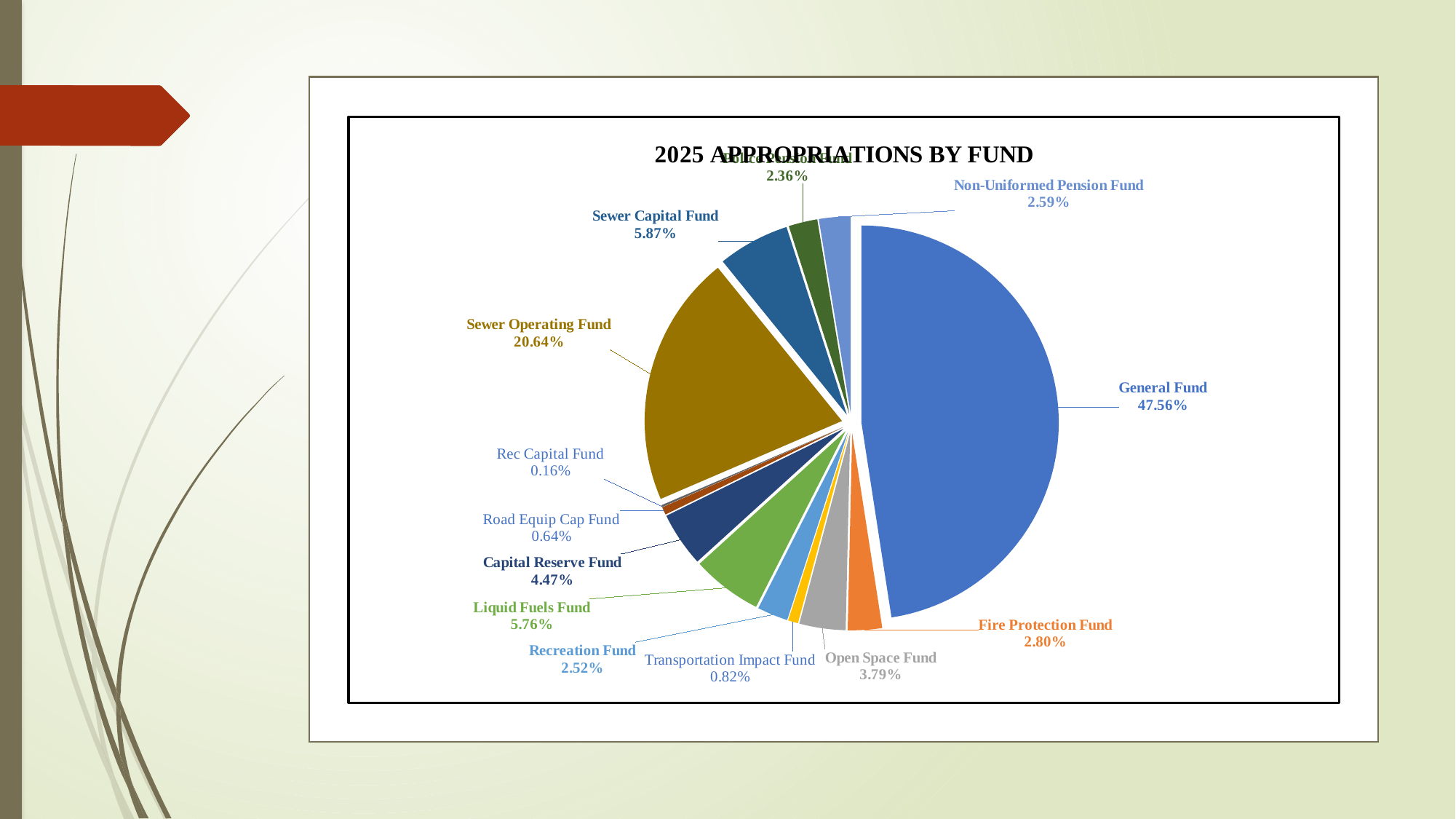
What percentage is shown for the Open Space Fund? 3.79% What percentage is shown for the Transportation Impact Fund? 0.82% What is the difference in percentage points between the General Fund and the Sewer Operating Fund? 26.92 Which fund has the smallest share of the pie? Rec Capital Fund Which fund has the largest share of the pie? General Fund What is the difference in percentage points between the Fire Protection Fund and the Recreation Fund? 0.28 Which has a larger share, the Sewer Capital Fund or the Liquid Fuels Fund? Sewer Capital Fund What percentage is shown for the Sewer Operating Fund? 20.64% What kind of chart is shown on the slide? Pie chart What share of the 2025 appropriations goes to the General Fund? 47.56% How many slices does the pie chart have? 13 What is the title of the chart? 2025 APPROPRIATIONS BY FUND